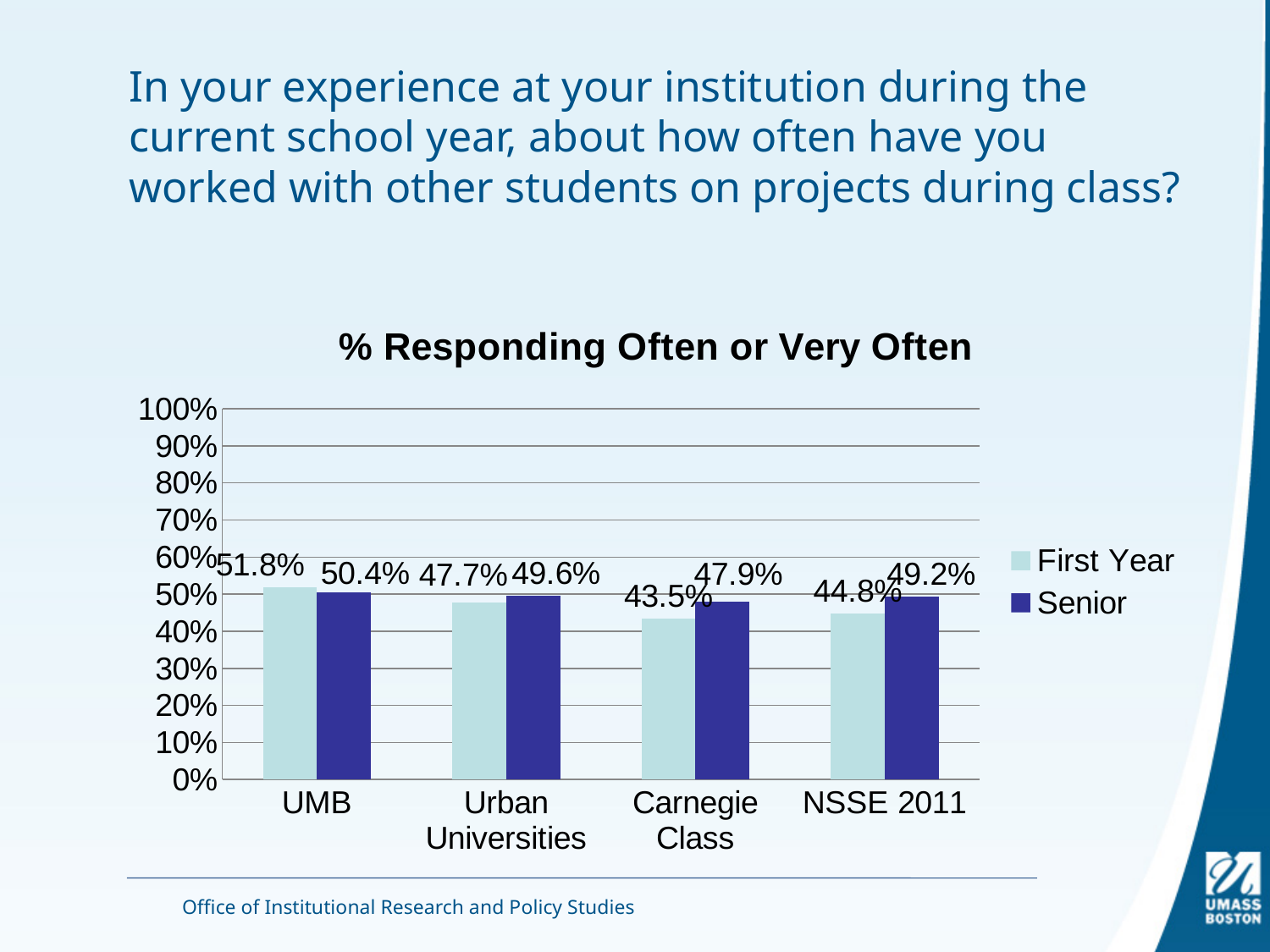
Which category has the highest First Year value? UMB What is the Senior value for Carnegie Class? 47.9% What is the Senior value for Urban Universities? 49.6% What is the title of the chart? % Responding Often or Very Often Which is larger for UMB, the First Year value or the Senior value? First Year What is the First Year value for NSSE 2011? 44.8% What is the difference between the First Year and Senior values for Carnegie Class? 4.4% How many series does the legend list? 2 What kind of chart is shown? Bar chart What is the First Year value for UMB? 51.8% Which category has the lowest First Year value? Carnegie Class How many categories are shown on the x axis? 4